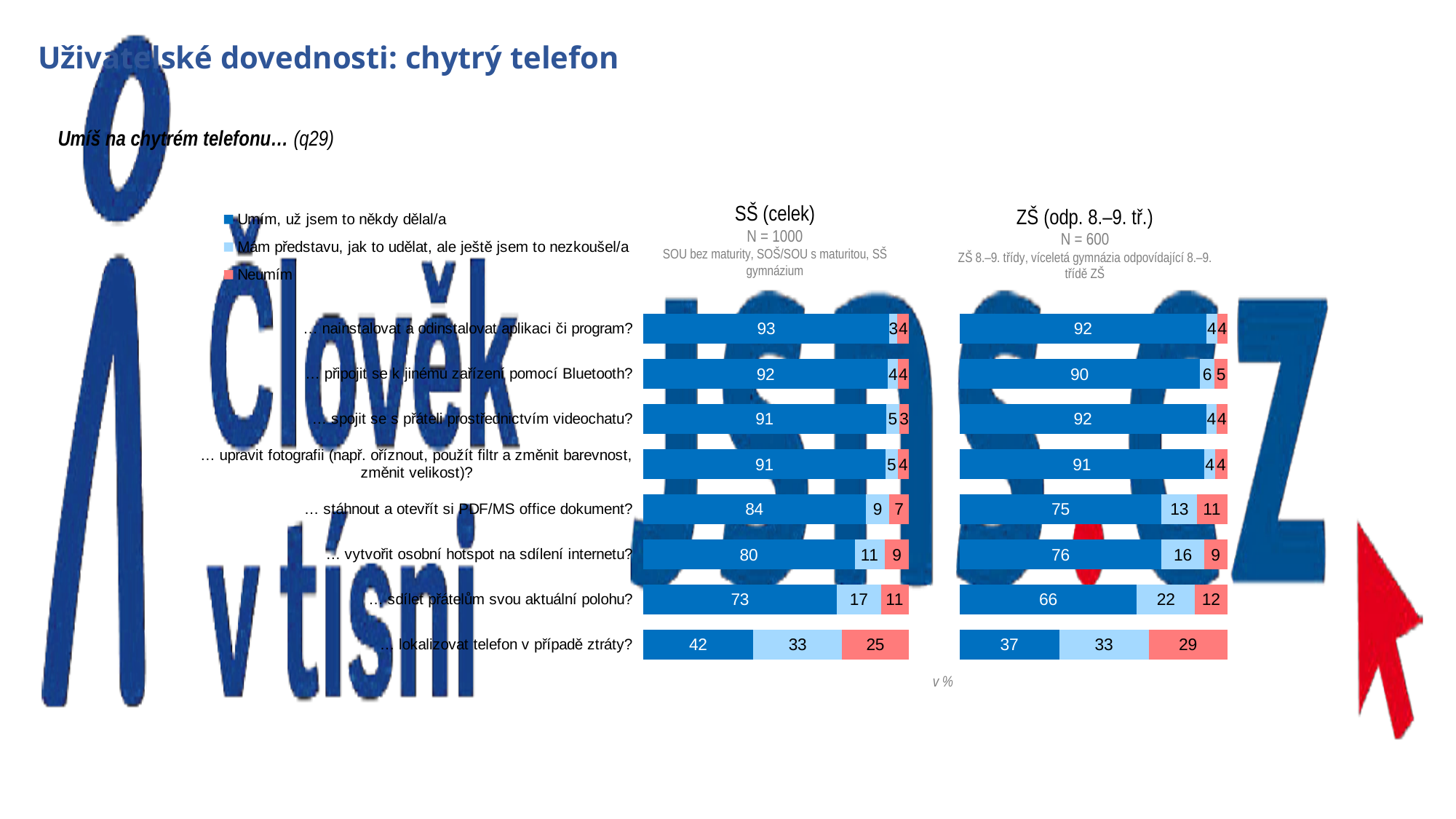
Which chart shows a higher "Umím, už jsem to někdy dělal/a" value for "… stáhnout a otevřít si PDF/MS office dokument?", SŠ (celek) or ZŠ (odp. 8.–9. tř.)? SŠ (celek) What is the sample size (N) shown for the ZŠ (odp. 8.–9. tř.) chart? N = 600 In the SŠ (celek) chart, what percentage answered "Umím, už jsem to někdy dělal/a" for "… lokalizovat telefon v případě ztráty?"? 42 How many items (categories) are listed in the SŠ (celek) chart? 8 In the SŠ (celek) chart, which item has the highest "Umím, už jsem to někdy dělal/a" value? … nainstalovat a odinstalovat aplikaci či program? In the ZŠ (odp. 8.–9. tř.) chart, what is the total of the three values for "… lokalizovat telefon v případě ztráty?"? 99 What type of chart is used for the SŠ (celek) data? Stacked bar chart In the SŠ (celek) chart, what is the difference between the "Umím, už jsem to někdy dělal/a" values for "… stáhnout a otevřít si PDF/MS office dokument?" and "… sdílet přátelům svou aktuální polohu?"? 11 In the ZŠ (odp. 8.–9. tř.) chart, what is the "Neumím" value for "… sdílet přátelům svou aktuální polohu?"? 12 In the ZŠ (odp. 8.–9. tř.) chart, what is the "Mám představu, jak to udělat, ale ještě jsem to nezkoušel/a" value for "… vytvořit osobní hotspot na sdílení internetu?"? 16 In the ZŠ (odp. 8.–9. tř.) chart, which item has the lowest "Umím, už jsem to někdy dělal/a" value? … lokalizovat telefon v případě ztráty? How many series does the legend list? 3